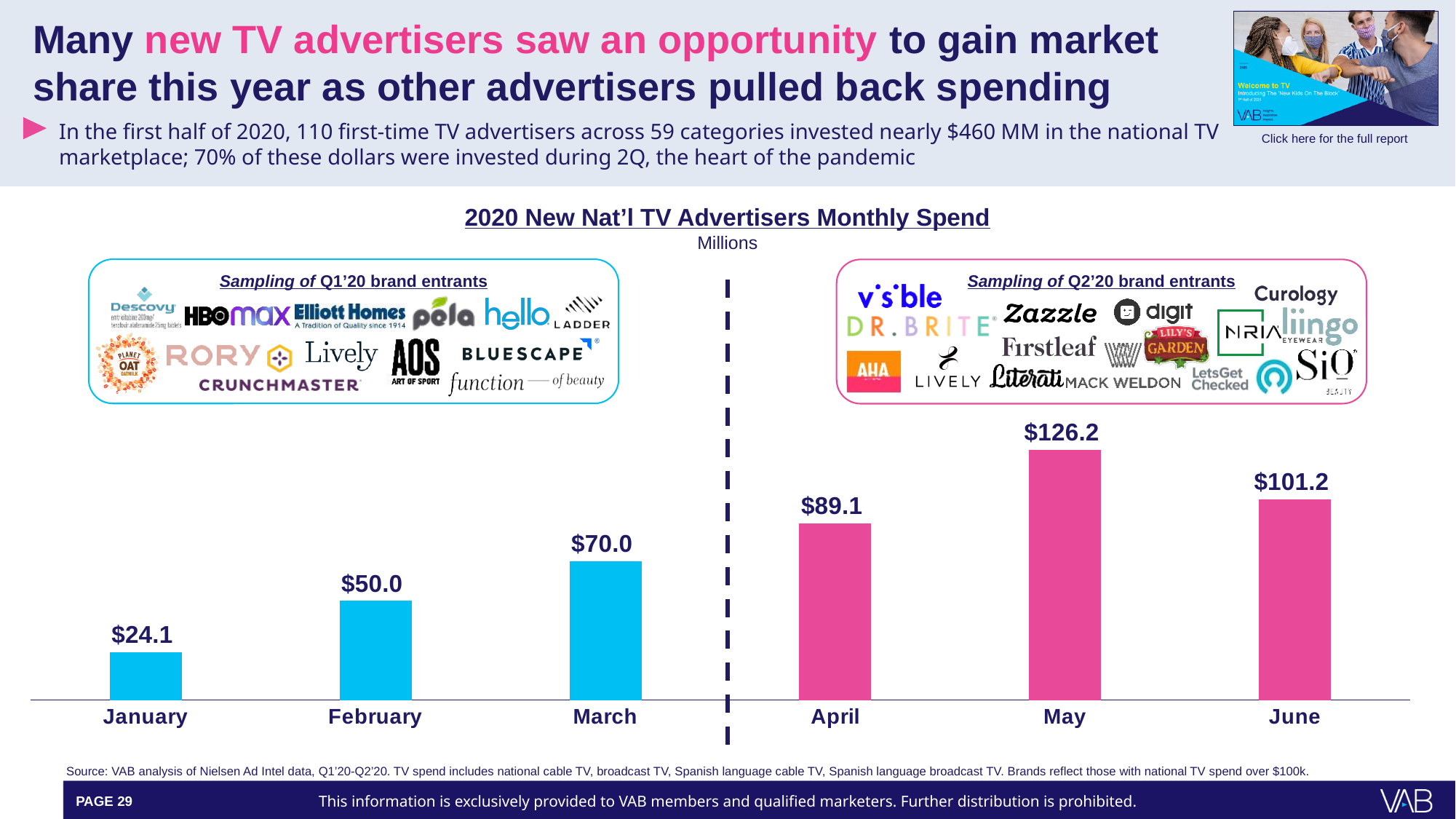
What is the title of the chart? 2020 New Nat'l TV Advertisers Monthly Spend How many months are shown on the chart? 6 Which month has the lowest spend? January Do the values rise or fall from January to March? Rise Which is larger, the value for April or the value for March? April What is the difference between the values for March and February? $20.0 What is the difference between the values for May and June? $25.0 Which month has the highest spend? May What is the value for January? $24.1 What kind of chart is this? Bar chart What is the value for April? $89.1 What is the value for May? $126.2